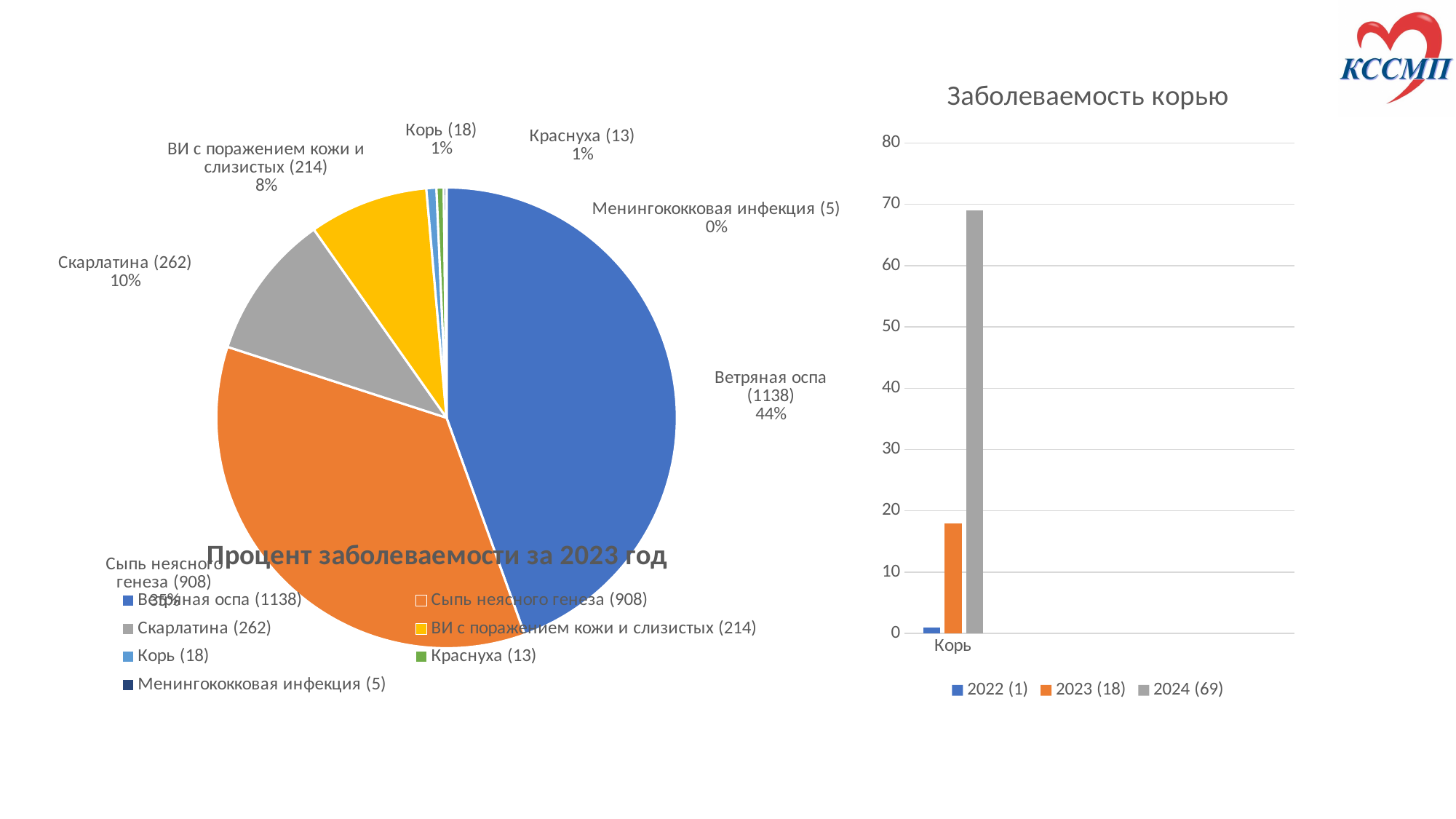
In the pie chart "Процент заболеваемости за 2023 год", what share does Скарлатина have? 10% In the pie chart "Процент заболеваемости за 2023 год", which category has the smallest slice? Менингококковая инфекция (5) In the bar chart "Заболеваемость корью", how many series does the legend list? 3 What kind of chart is the chart titled "Заболеваемость корью"? bar chart In the pie chart "Процент заболеваемости за 2023 год", which category has the largest slice? Ветряная оспа (1138) In the bar chart "Заболеваемость корью", which series has the tallest bar? 2024 (69) What kind of chart is the chart titled "Процент заболеваемости за 2023 год"? pie chart In the bar chart "Заболеваемость корью", what is the difference between the 2024 value and the 2023 value shown in the legend? 51 In the pie chart "Процент заболеваемости за 2023 год", what share does Ветряная оспа have? 44% In the pie chart "Процент заболеваемости за 2023 год", what is the count shown for ВИ с поражением кожи и слизистых? 214 In the bar chart "Заболеваемость корью", is the value for 2024 greater or less than 60? greater In the pie chart "Процент заболеваемости за 2023 год", how many categories are shown? 7